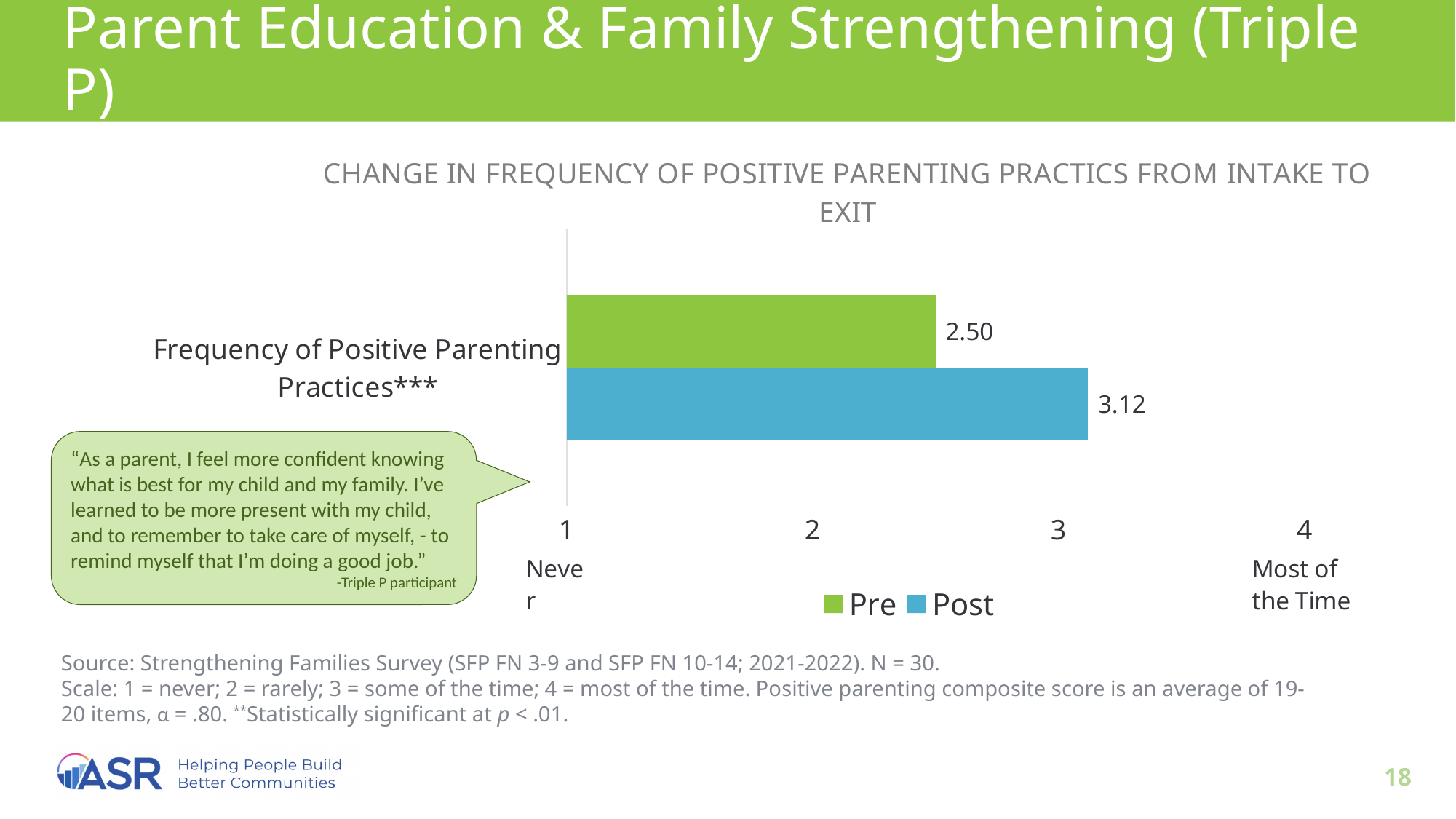
How many series does the legend list? 2 How many categories are shown on the chart? 1 What is the title of the chart? CHANGE IN FREQUENCY OF POSITIVE PARENTING PRACTICS FROM INTAKE TO EXIT What is the difference between the Post and Pre values? 0.62 What is the Post value for Frequency of Positive Parenting Practices? 3.12 Is the Post value greater or less than 3? greater Is the Pre value greater or less than 3? less What is the Pre value for Frequency of Positive Parenting Practices? 2.50 Which series has the higher value, Pre or Post? Post What colour represents the Post series? Blue What is the maximum value shown on the chart's axis? 4 What kind of chart is shown on the slide? Bar chart